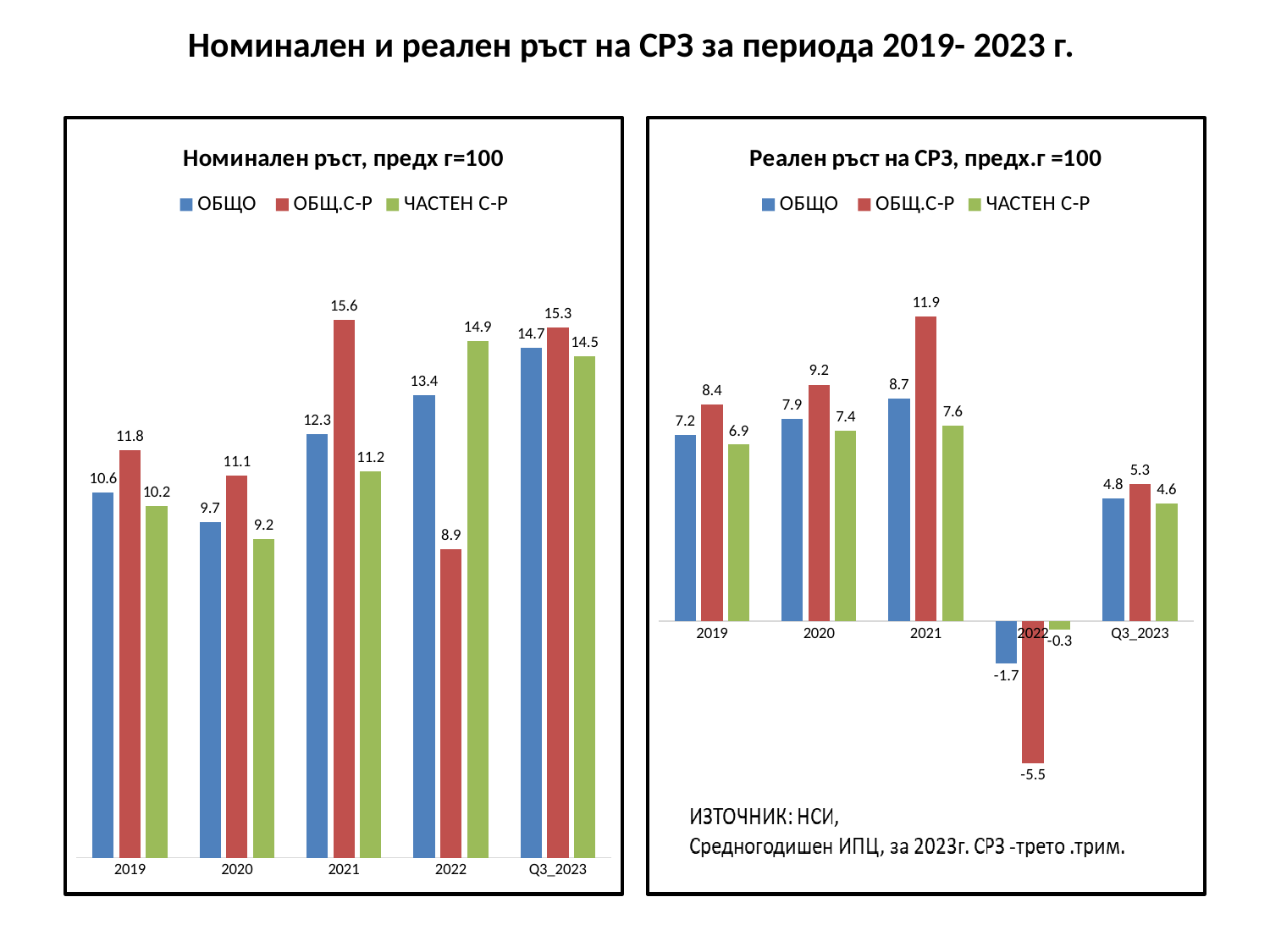
How many series does the legend of the right chart (Реален ръст на СРЗ, предх.г =100) list? 3 In the left chart (Номинален ръст, предх г=100), what is the difference between ОБЩО in Q3_2023 and ОБЩО in 2019? 4.1 In the right chart (Реален ръст на СРЗ, предх.г =100), which year has the highest value for ОБЩ.С-Р? 2021 In the left chart (Номинален ръст, предх г=100), which year has the lowest value for ОБЩ.С-Р? 2022 In the right chart (Реален ръст на СРЗ, предх.г =100), what is the value for ОБЩО in 2020? 7.9 In the right chart (Реален ръст на СРЗ, предх.г =100), what is the difference between ОБЩ.С-Р and ЧАСТЕН С-Р in 2021? 4.3 In the left chart (Номинален ръст, предх г=100), what is the value for ОБЩ.С-Р in 2021? 15.6 In the left chart (Номинален ръст, предх г=100), what is the value for ЧАСТЕН С-Р in 2022? 14.9 What type of chart is the left chart (Номинален ръст, предх г=100)? Bar chart In the right chart (Реален ръст на СРЗ, предх.г =100), which is larger in 2019: ОБЩ.С-Р or ЧАСТЕН С-Р? ОБЩ.С-Р In the left chart (Номинален ръст, предх г=100), how many year categories are shown on the x axis? 5 In the right chart (Реален ръст на СРЗ, предх.г =100), what is the value for ОБЩ.С-Р in 2022? -5.5